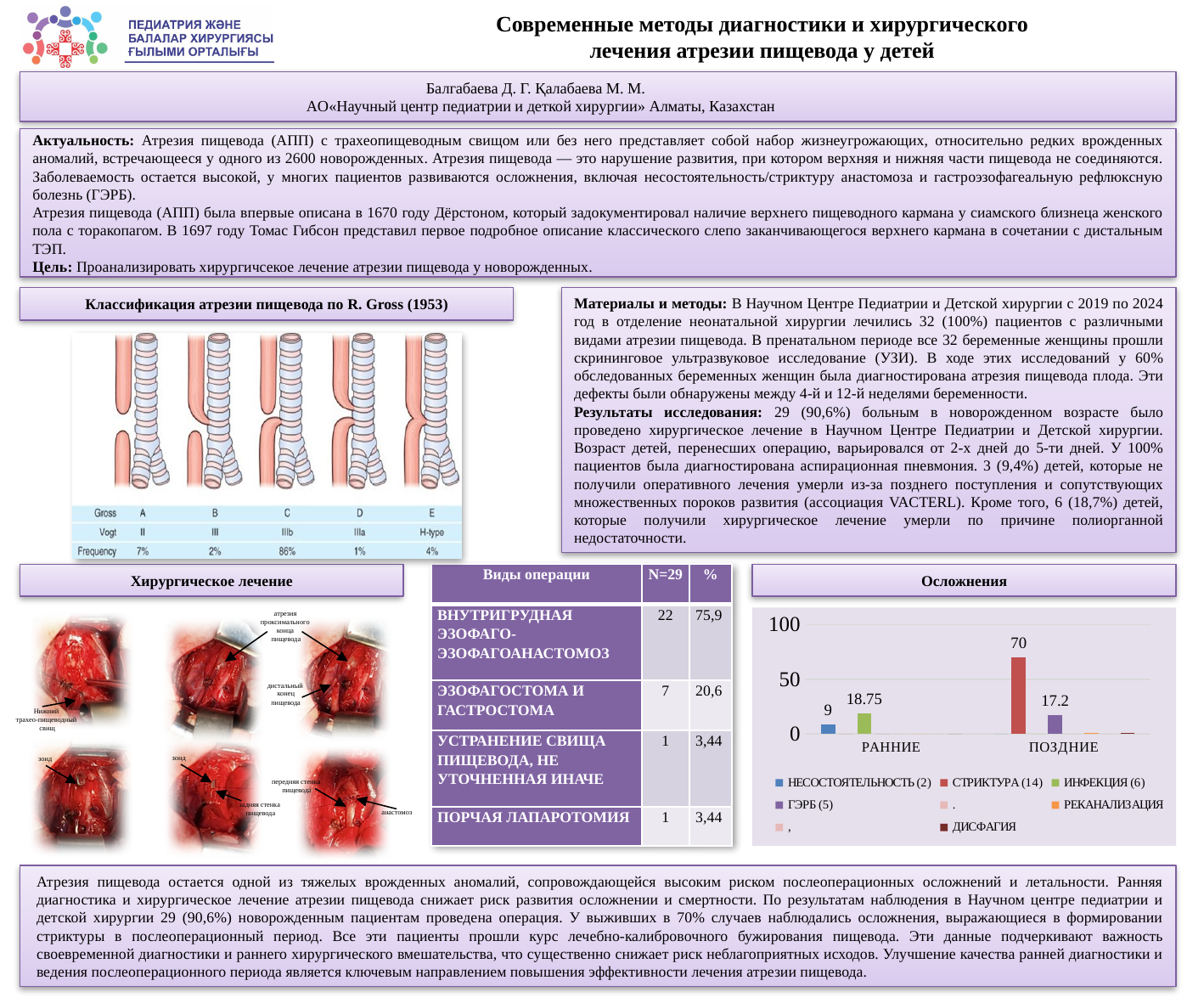
What type of chart is the Осложнения chart? bar chart In the Осложнения chart, which series has the highest labelled value? СТРИКТУРА In the Осложнения chart, what is the value of the ИНФЕКЦИЯ bar in the РАННИЕ category? 18.75 In the Осложнения chart, what is the value of the НЕСОСТОЯТЕЛЬНОСТЬ bar in the РАННИЕ category? 9 In the Осложнения chart, what is the difference between the СТРИКТУРА value (70) and the ГЭРБ value (17.2) in the ПОЗДНИЕ category? 52.8 In the Осложнения chart, what is the difference between the ИНФЕКЦИЯ value and the НЕСОСТОЯТЕЛЬНОСТЬ value in the РАННИЕ category? 9.75 How many entries does the legend of the Осложнения chart list? 8 How many categories are shown on the x axis of the Осложнения chart? 2 In the Осложнения chart, what is the value of the СТРИКТУРА bar in the ПОЗДНИЕ category? 70 In the Осложнения chart, is the value for СТРИКТУРА in ПОЗДНИЕ greater or less than 50? greater In the Осложнения chart, which is larger: the ИНФЕКЦИЯ value in РАННИЕ or the ГЭРБ value in ПОЗДНИЕ? ИНФЕКЦИЯ In the Осложнения chart, what is the value of the ГЭРБ bar in the ПОЗДНИЕ category? 17.2